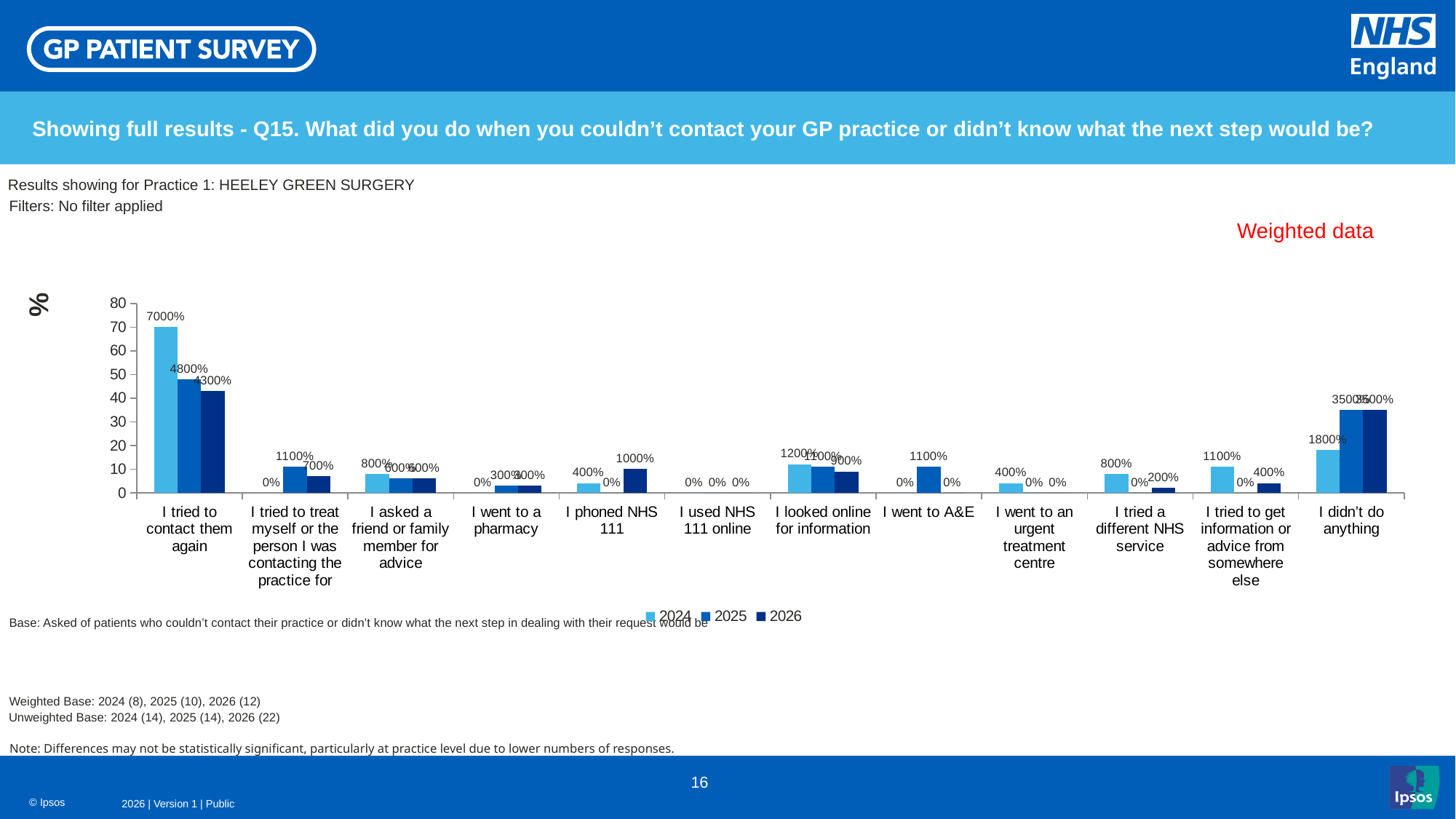
What is the data label for 2026 on 'I phoned NHS 111'? 1000% What is the data label for 2026 on 'I tried to contact them again'? 4300% How many series does the legend list? 3 How many categories are shown along the x axis? 12 Which category has the highest 2024 bar? I tried to contact them again Which is larger for 'I tried to treat myself or the person I was contacting the practice for': the 2025 value or the 2026 value? 2025 What is the data label for 2024 on 'I tried to contact them again'? 7000% What kind of chart is shown on the slide? bar chart What is the difference between the 2024 and 2025 data labels for 'I tried to contact them again'? 2200% Which series is shown in the lightest blue in the legend? 2024 What is the data label for 2024 on 'I didn't do anything'? 1800% What is the data label for 2025 on 'I went to A&E'? 1100%